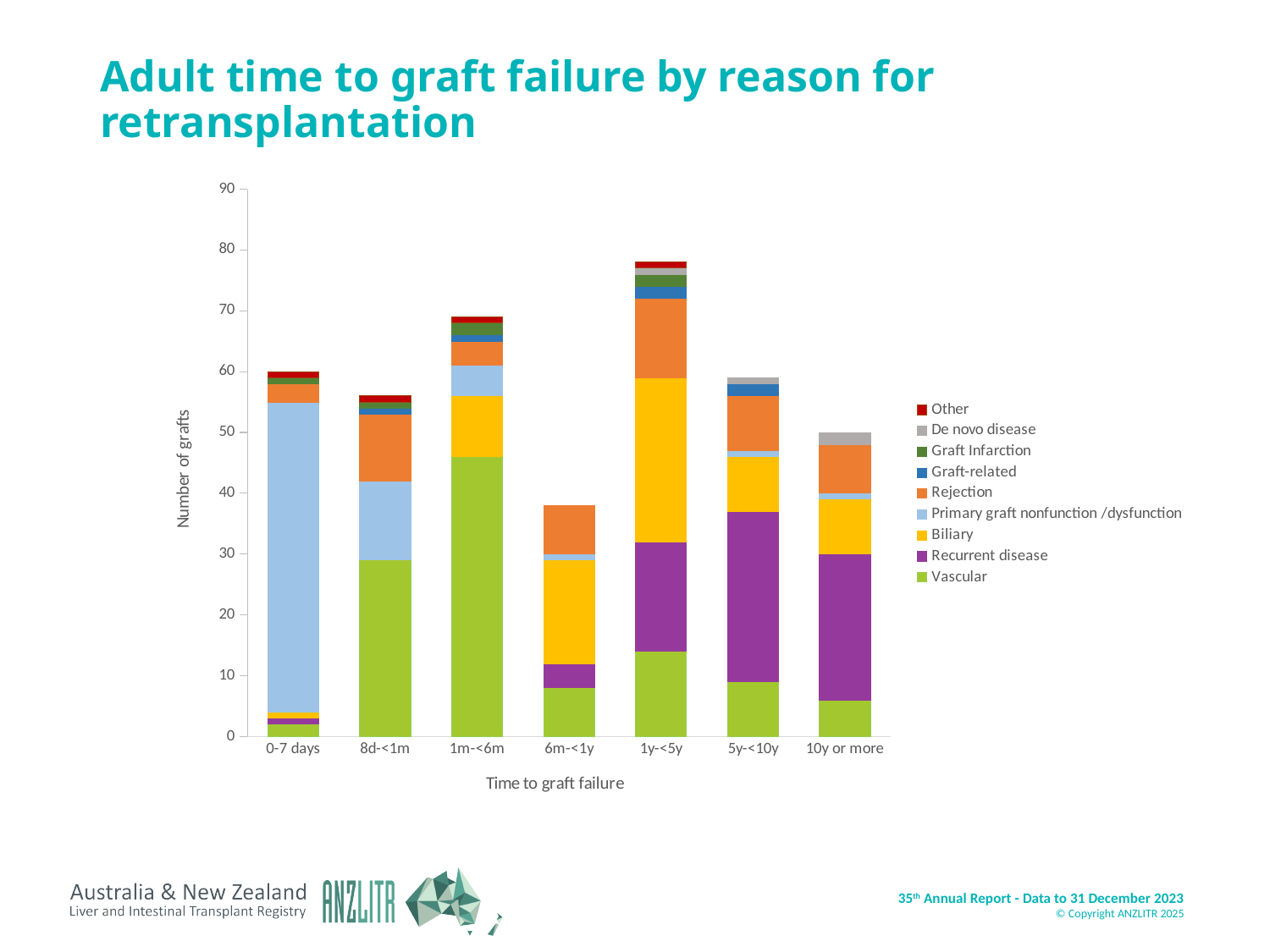
Is the total number of grafts for 10y or more greater or less than 60? less Which has a larger total number of grafts, 1m-<6m or 8d-<1m? 1m-<6m How many time-to-graft-failure categories are shown on the x axis? 7 What kind of chart is shown on the slide? Stacked bar chart Which has a larger total number of grafts, 5y-<10y or 6m-<1y? 5y-<10y Which time-to-graft-failure category has the highest total number of grafts? 1y-<5y Is the total number of grafts for 6m-<1y greater or less than 40? less What is the title of the chart's x axis? Time to graft failure How many series does the legend list? 9 Is the total number of grafts for 1m-<6m greater or less than 60? greater Which time-to-graft-failure category has the lowest total number of grafts? 6m-<1y